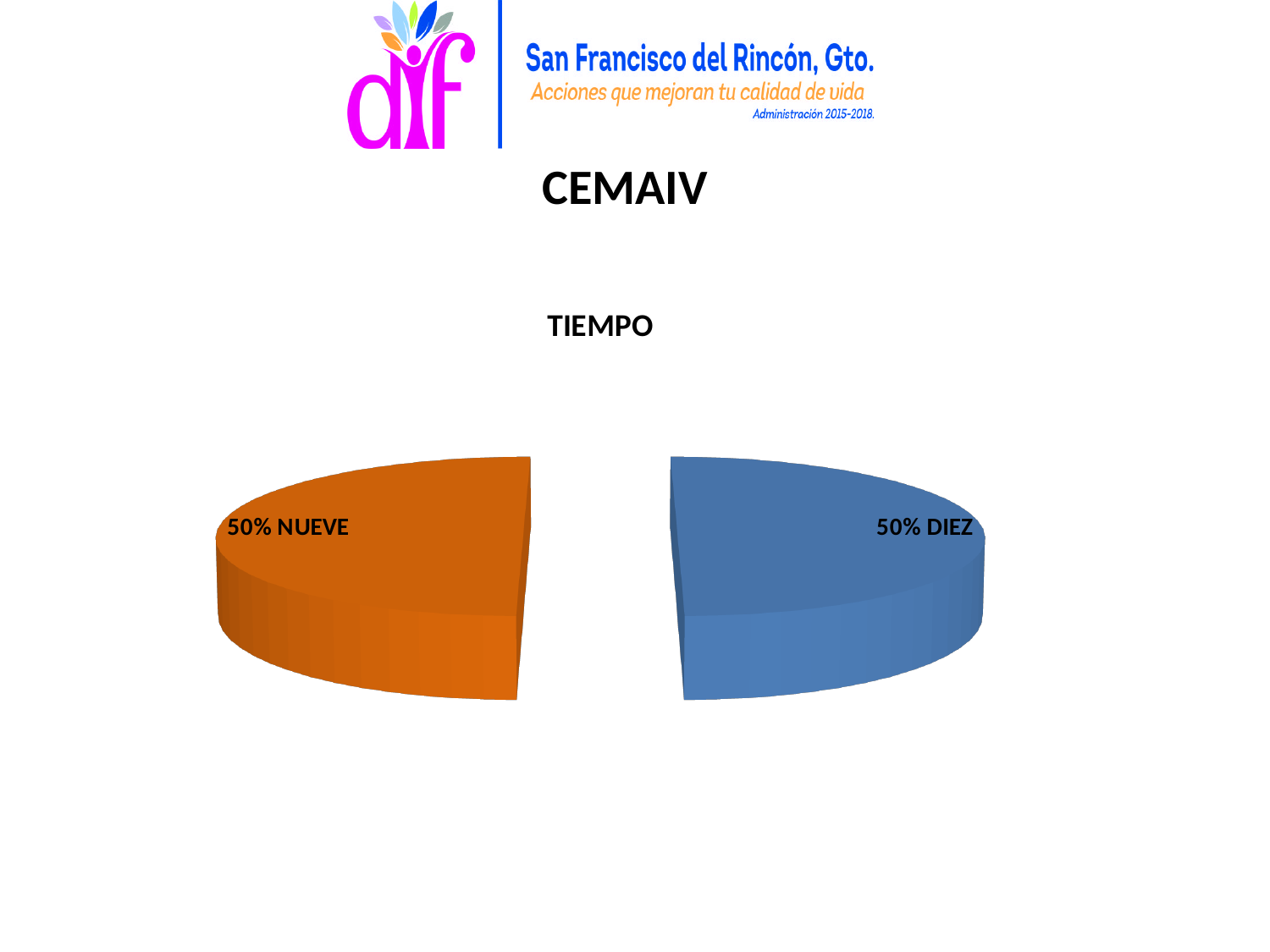
What share of the pie does the NUEVE slice represent? 50% What colour is the NUEVE slice? orange What kind of chart is shown on the slide? pie chart What is the title of the chart? TIEMPO How many slices does the pie chart have? 2 What is the combined share of the NUEVE and DIEZ slices? 100% What is the label of the blue slice? DIEZ What is the difference between the shares of NUEVE and DIEZ? 0% What share of the pie does the DIEZ slice represent? 50%